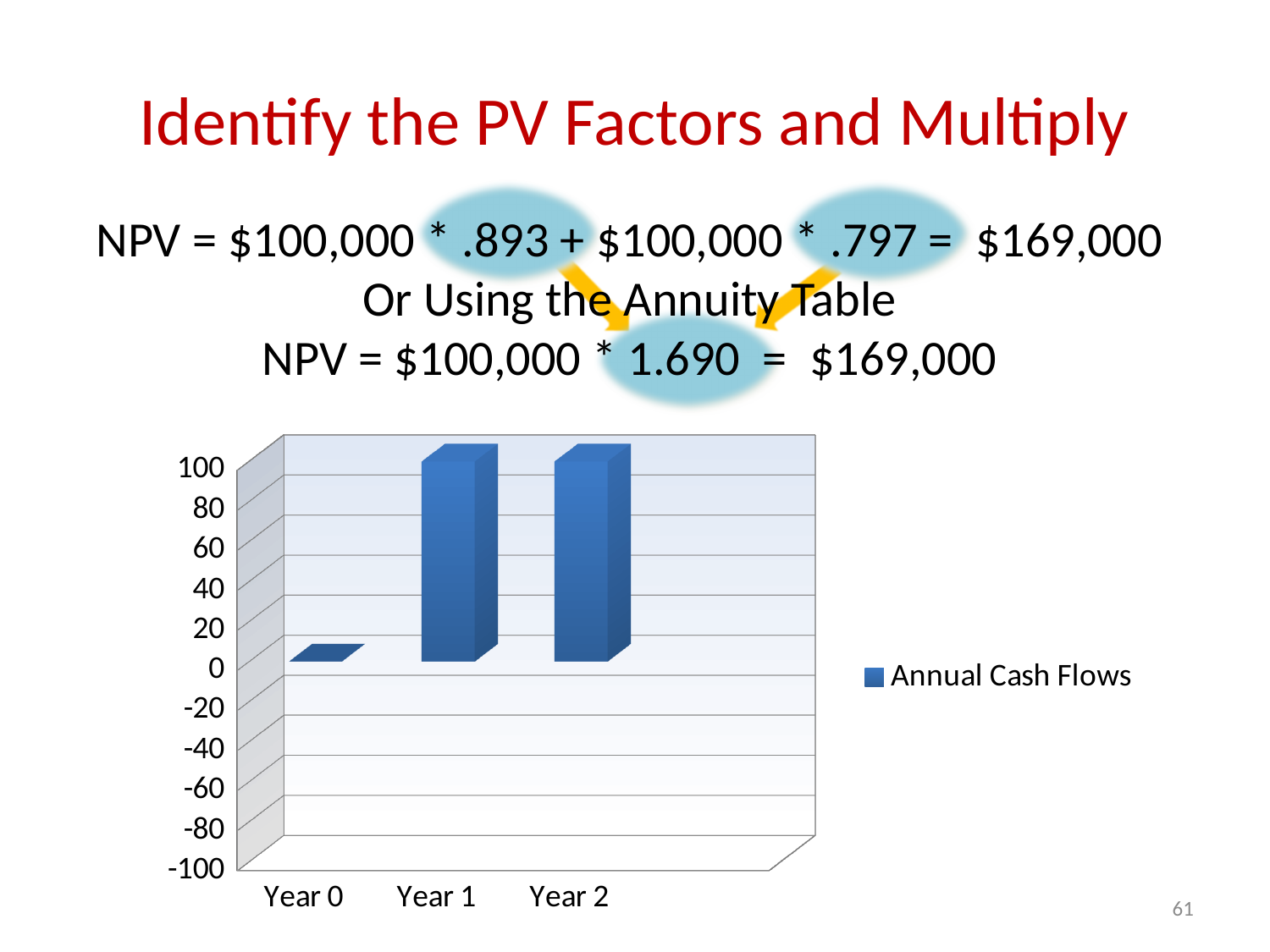
Does the Annual Cash Flows value rise or fall from Year 0 to Year 1? rise What is the name of the series shown in the chart legend? Annual Cash Flows Which year has the lowest Annual Cash Flows value in the chart? Year 0 Is the value for Year 2 greater or less than 60? greater What is the lowest value shown on the chart's vertical axis? -100 How many categories are shown on the x axis of the chart? 3 Is the value for Year 1 greater or less than 80? greater How many series does the chart legend list? 1 Which has the larger Annual Cash Flows value, Year 0 or Year 1? Year 1 What kind of chart is shown on the slide? bar chart Which has the larger Annual Cash Flows value, Year 0 or Year 2? Year 2 Is the value for Year 0 greater or less than 20? less